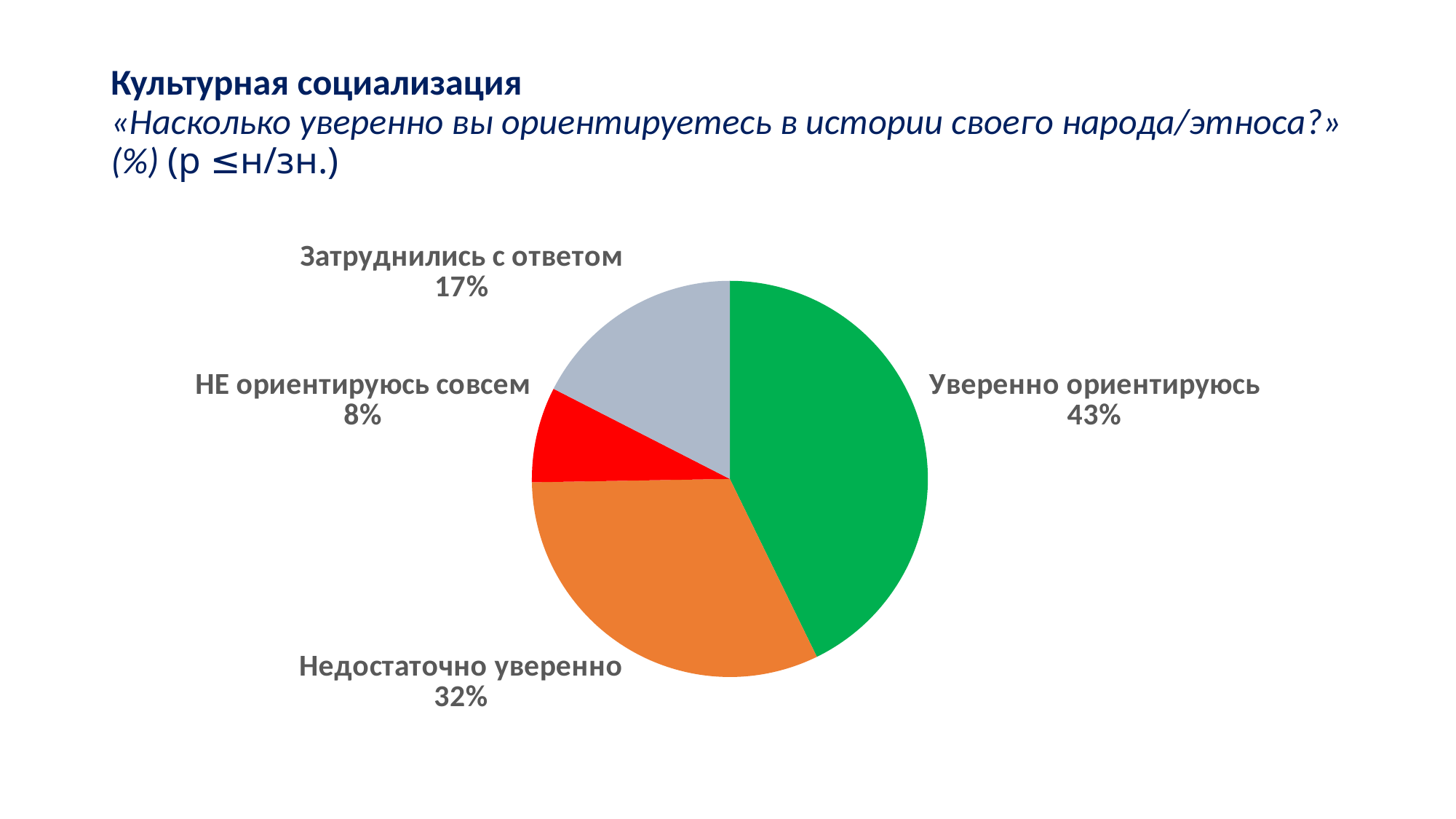
Which response category has the largest share of the pie? Уверенно ориентируюсь Which response category has the smallest share of the pie? НЕ ориентируюсь совсем What percentage of respondents answered «НЕ ориентируюсь совсем»? 8% What colour is the slice for «Недостаточно уверенно»? orange What percentage of respondents answered «Уверенно ориентируюсь»? 43% What is the combined share of «Уверенно ориентируюсь» and «Недостаточно уверенно»? 75% How many response categories are shown in the pie chart? 4 Which is larger: the share for «Затруднились с ответом» or the share for «НЕ ориентируюсь совсем»? Затруднились с ответом What is the difference in percentage points between «Уверенно ориентируюсь» and «Недостаточно уверенно»? 11 What percentage of respondents answered «Недостаточно уверенно»? 32% What percentage of respondents answered «Затруднились с ответом»? 17% What type of chart is shown on the slide? pie chart